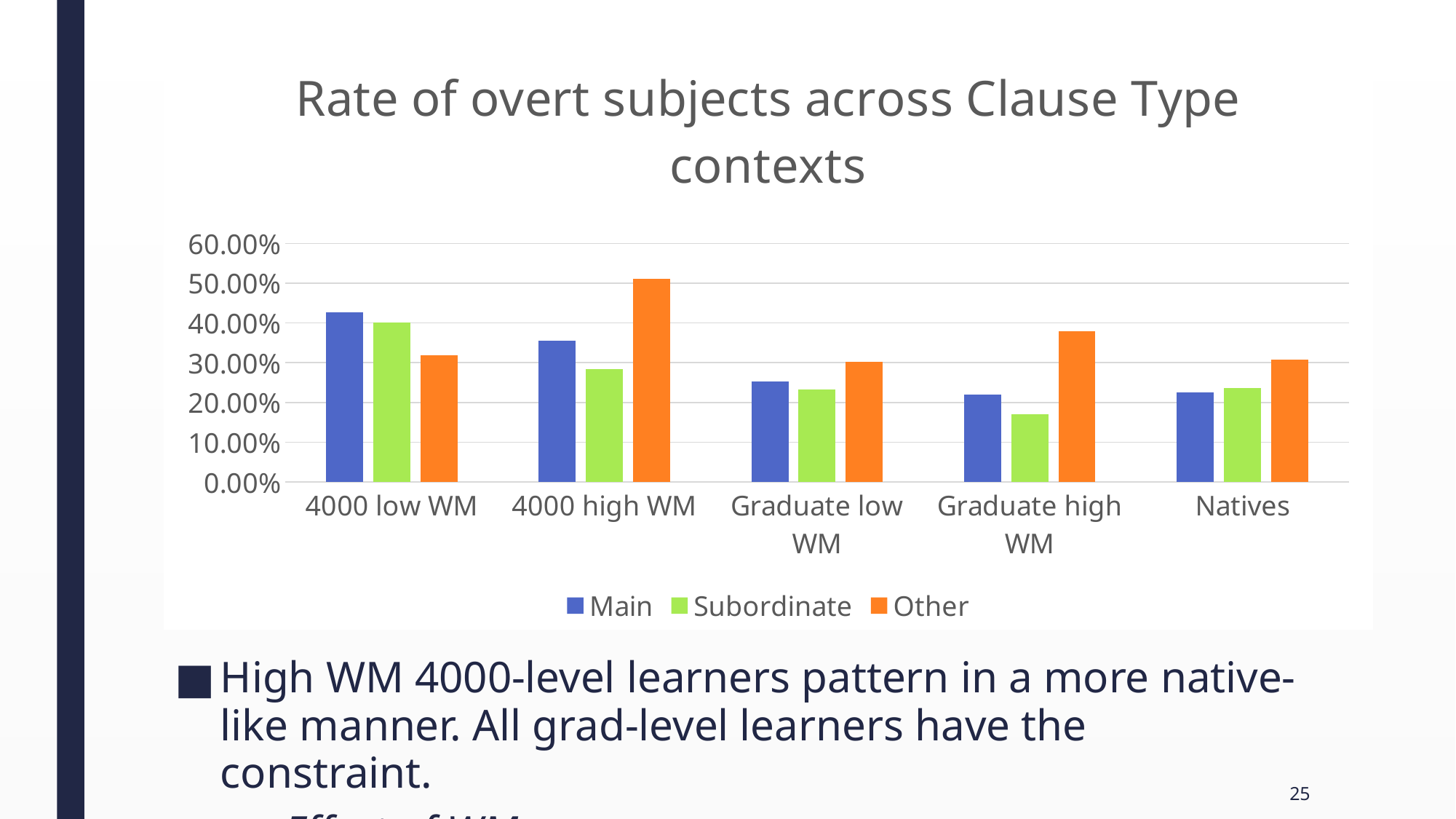
How many series does the legend list? 3 Is the Other value for 4000 high WM greater or less than 40.00%? greater Which category has the lowest value for the Subordinate series? Graduate high WM What is the title of the chart? Rate of overt subjects across Clause Type contexts What type of chart is shown on the slide? bar chart Is the Subordinate value for Graduate high WM greater or less than 20.00%? less Which category has the highest value for the Other series? 4000 high WM For 4000 high WM, which is larger: the Main value or the Subordinate value? Main Which category has the highest value for the Main series? 4000 low WM Is the Main value for 4000 low WM greater or less than 40.00%? greater Which series is shown in orange in the legend? Other How many categories are shown on the x axis? 5